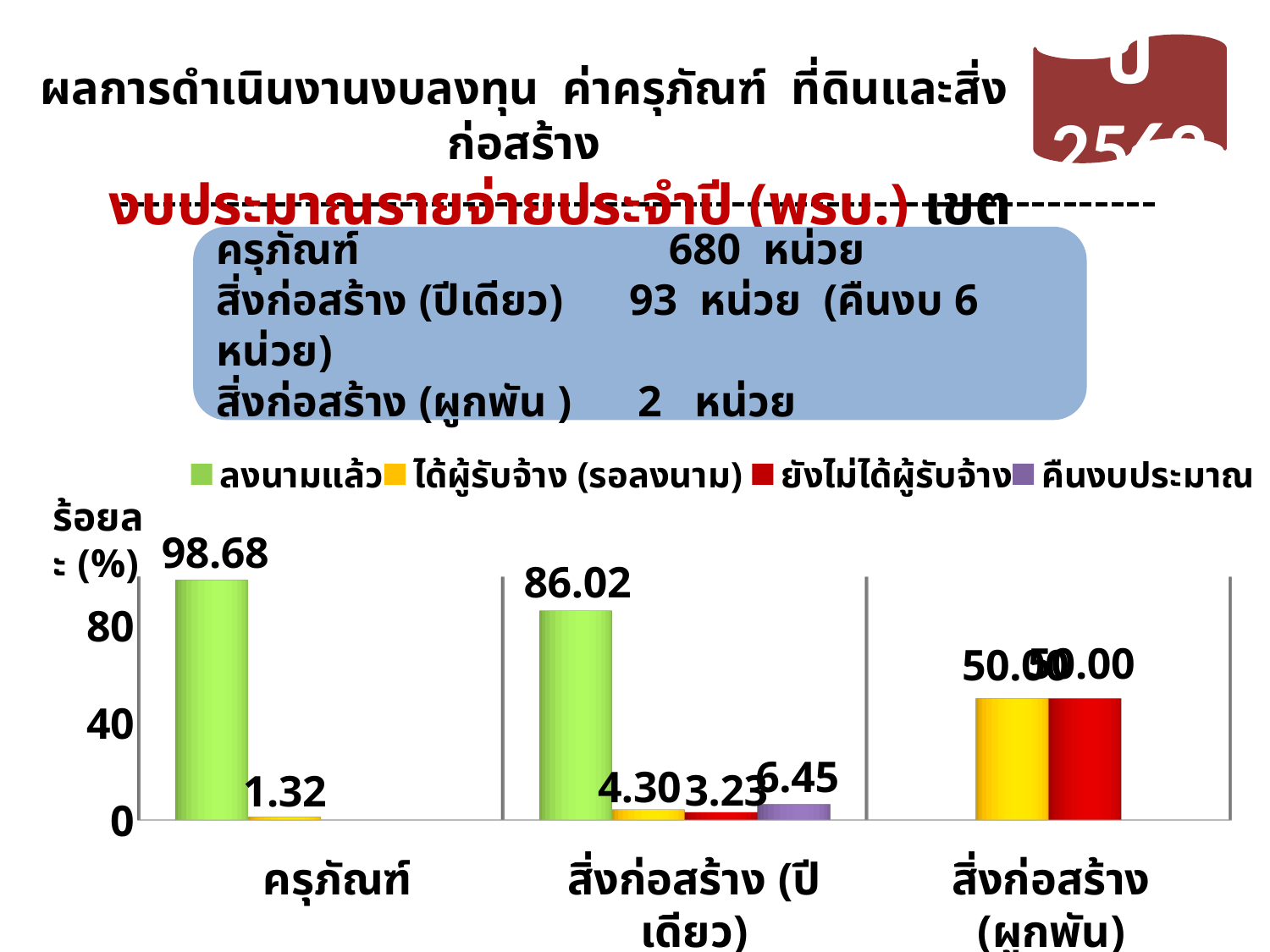
What is the label of the vertical axis of the chart? ร้อยละ (%) What is the value of คืนงบประมาณ for สิ่งก่อสร้าง (ปีเดียว)? 6.45 What is the value of ลงนามแล้ว for ครุภัณฑ์? 98.68 What is the value of ลงนามแล้ว for สิ่งก่อสร้าง (ปีเดียว)? 86.02 How many categories are shown on the x axis of the chart? 3 Which category has the highest value for ลงนามแล้ว? ครุภัณฑ์ What is the value of ยังไม่ได้ผู้รับจ้าง for สิ่งก่อสร้าง (ผูกพัน)? 50.00 What is the value of ได้ผู้รับจ้าง (รอลงนาม) for ครุภัณฑ์? 1.32 What is the difference between the ลงนามแล้ว values for ครุภัณฑ์ and สิ่งก่อสร้าง (ปีเดียว)? 12.66 How many series does the chart legend list? 4 What type of chart is shown on the slide? bar chart For สิ่งก่อสร้าง (ปีเดียว), which is larger: ได้ผู้รับจ้าง (รอลงนาม) or คืนงบประมาณ? คืนงบประมาณ